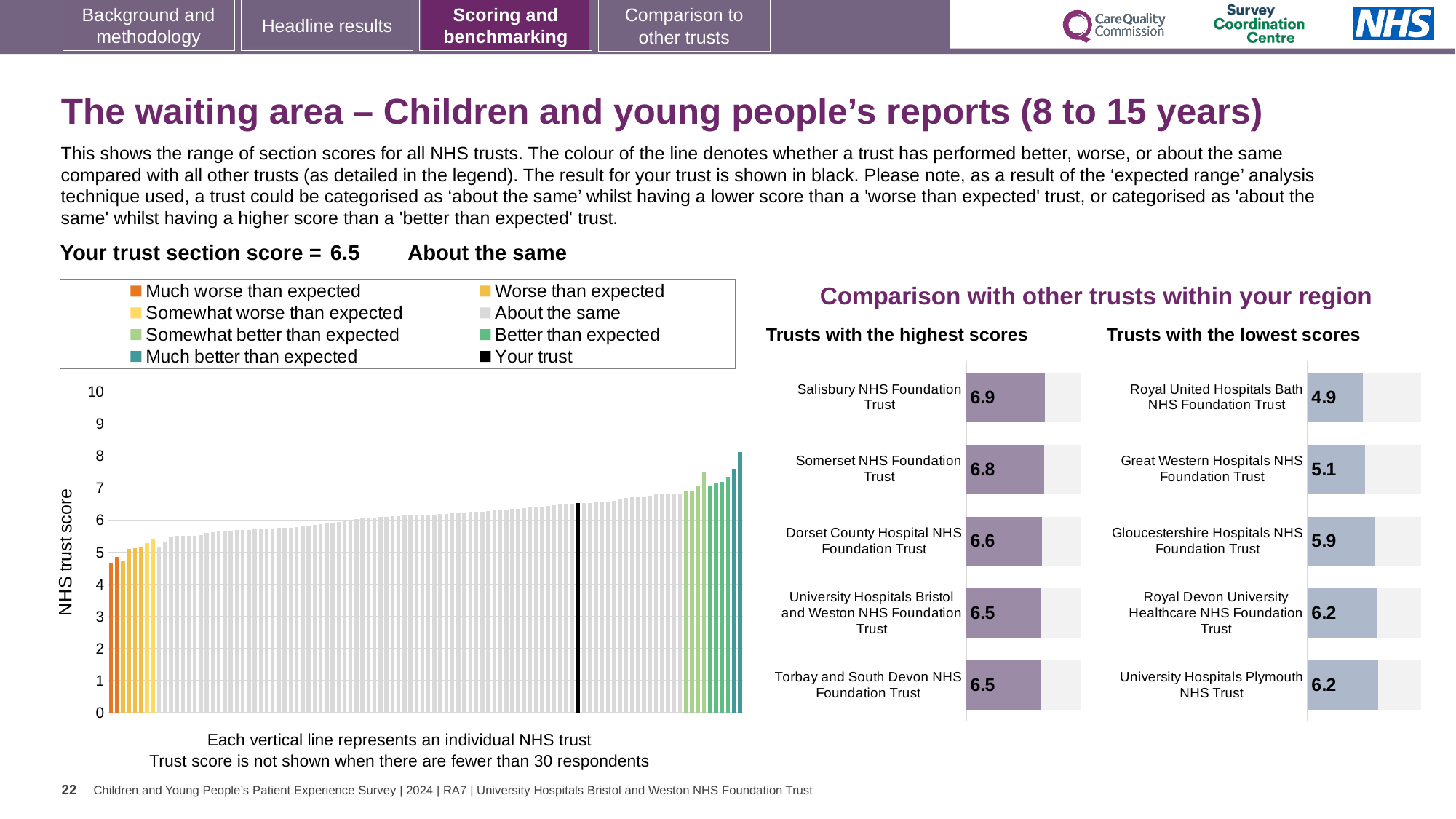
In the 'Trusts with the highest scores' chart, which trust has the highest score? Salisbury NHS Foundation Trust In the 'Trusts with the lowest scores' chart, which has the higher score: Great Western Hospitals NHS Foundation Trust or Gloucestershire Hospitals NHS Foundation Trust? Gloucestershire Hospitals NHS Foundation Trust In the 'Trusts with the lowest scores' chart, what is the score for Royal United Hospitals Bath NHS Foundation Trust? 4.9 In the large chart on the left, do the trust scores rise or fall from left to right? Rise What kind of chart is the large chart on the left showing NHS trust scores? Bar chart In the large chart on the left, is the value of the lowest bar greater or less than 5? less In the 'Trusts with the highest scores' chart, what is the difference between the scores of Salisbury NHS Foundation Trust and Dorset County Hospital NHS Foundation Trust? 0.3 In the 'Trusts with the lowest scores' chart, what is the difference between the scores of Gloucestershire Hospitals NHS Foundation Trust and Great Western Hospitals NHS Foundation Trust? 0.8 In the 'Trusts with the highest scores' chart, what is the score for Dorset County Hospital NHS Foundation Trust? 6.6 In the 'Trusts with the lowest scores' chart, which trust has the lowest score? Royal United Hospitals Bath NHS Foundation Trust In the 'Trusts with the highest scores' chart, what is the score for Salisbury NHS Foundation Trust? 6.9 How many trusts are shown in the 'Trusts with the highest scores' chart? 5